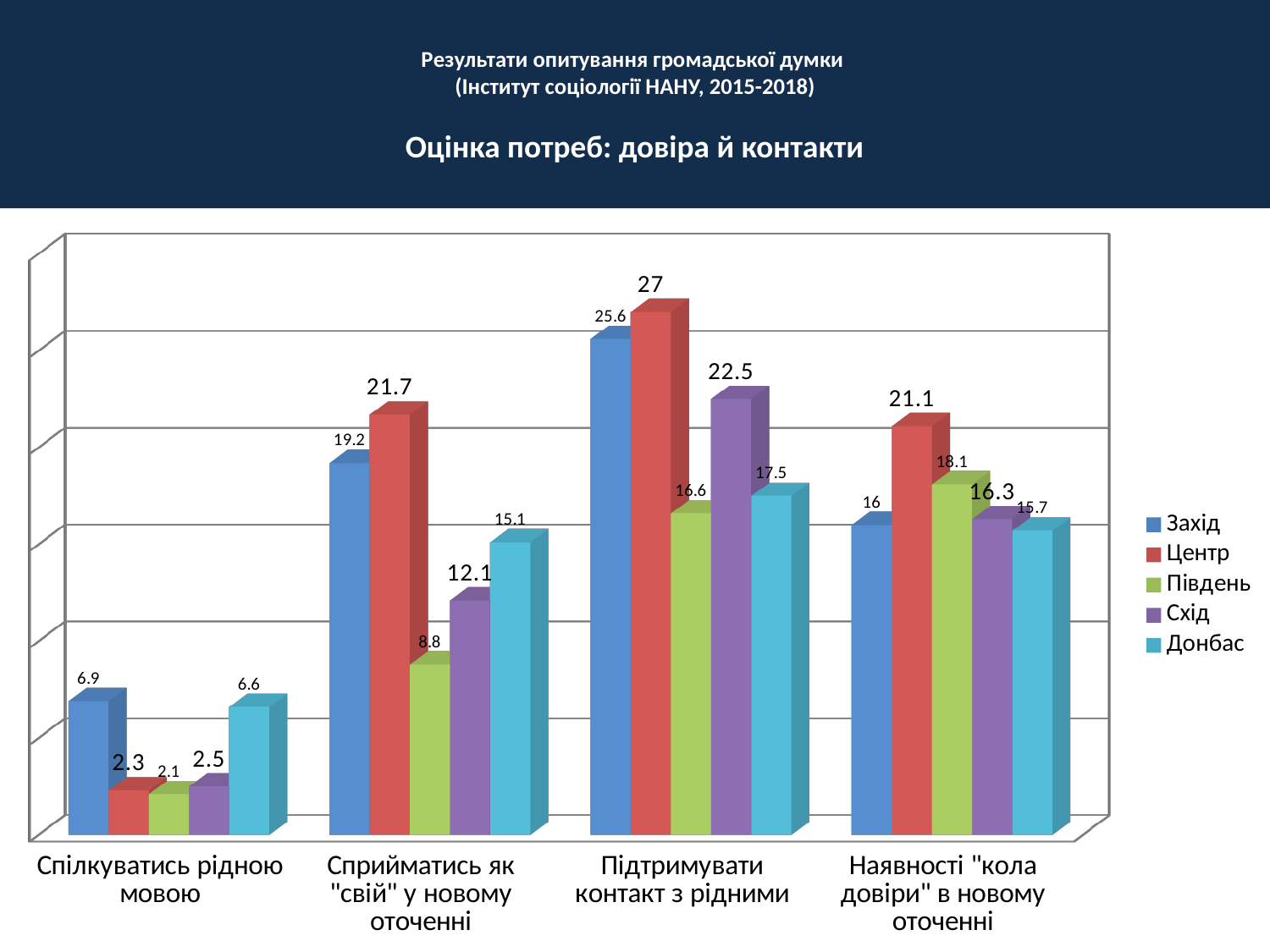
How many categories are shown on the x axis of the chart? 4 What is the value for Схід in the category "Наявності "кола довіри" в новому оточенні"? 16.3 Which series has the lowest value in the category "Сприйматись як "свій" у новому оточенні"? Південь What kind of chart is shown on the slide? Bar chart What is the value for Донбас in the category "Спілкуватись рідною мовою"? 6.6 What is the value for Південь in the category "Сприйматись як "свій" у новому оточенні"? 8.8 How many series does the legend list? 5 What is the value for Центр in the category "Підтримувати контакт з рідними"? 27 Which is larger in the category "Наявності "кола довіри" в новому оточенні": the value for Південь or the value for Донбас? Південь Which series has the highest value in the category "Підтримувати контакт з рідними"? Центр What is the difference between the Центр and Захід values in the category "Сприйматись як "свій" у новому оточенні"? 2.5 Which legend entry is shown in purple? Схід